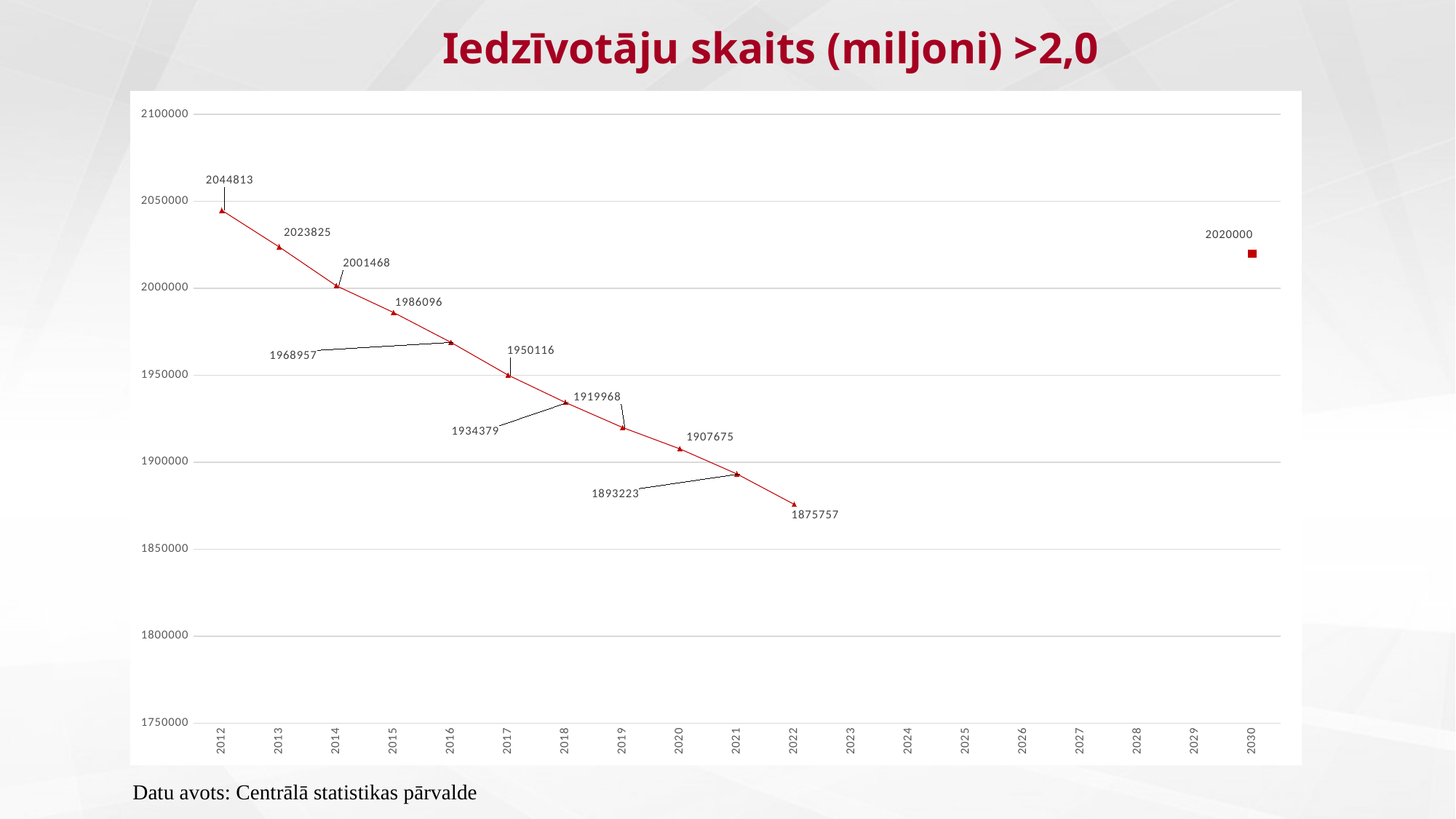
Which year on the line has the highest population value? 2012 What is the difference between the 2030 value and the 2022 value? 144243 What value is shown for 2030? 2020000 Do the values on the line rise or fall from 2012 to 2022? fall Is the value for 2015 greater or less than 2000000? less Which is larger, the value for 2014 or the value for 2016? 2014 Which year on the line has the lowest population value? 2022 What is the difference between the 2012 value and the 2022 value? 169056 What is the population value shown for 2012? 2044813 What is the population value shown for 2017? 1950116 What is the title of the chart? Iedzīvotāju skaits (miljoni) >2,0 What is the population value shown for 2022? 1875757